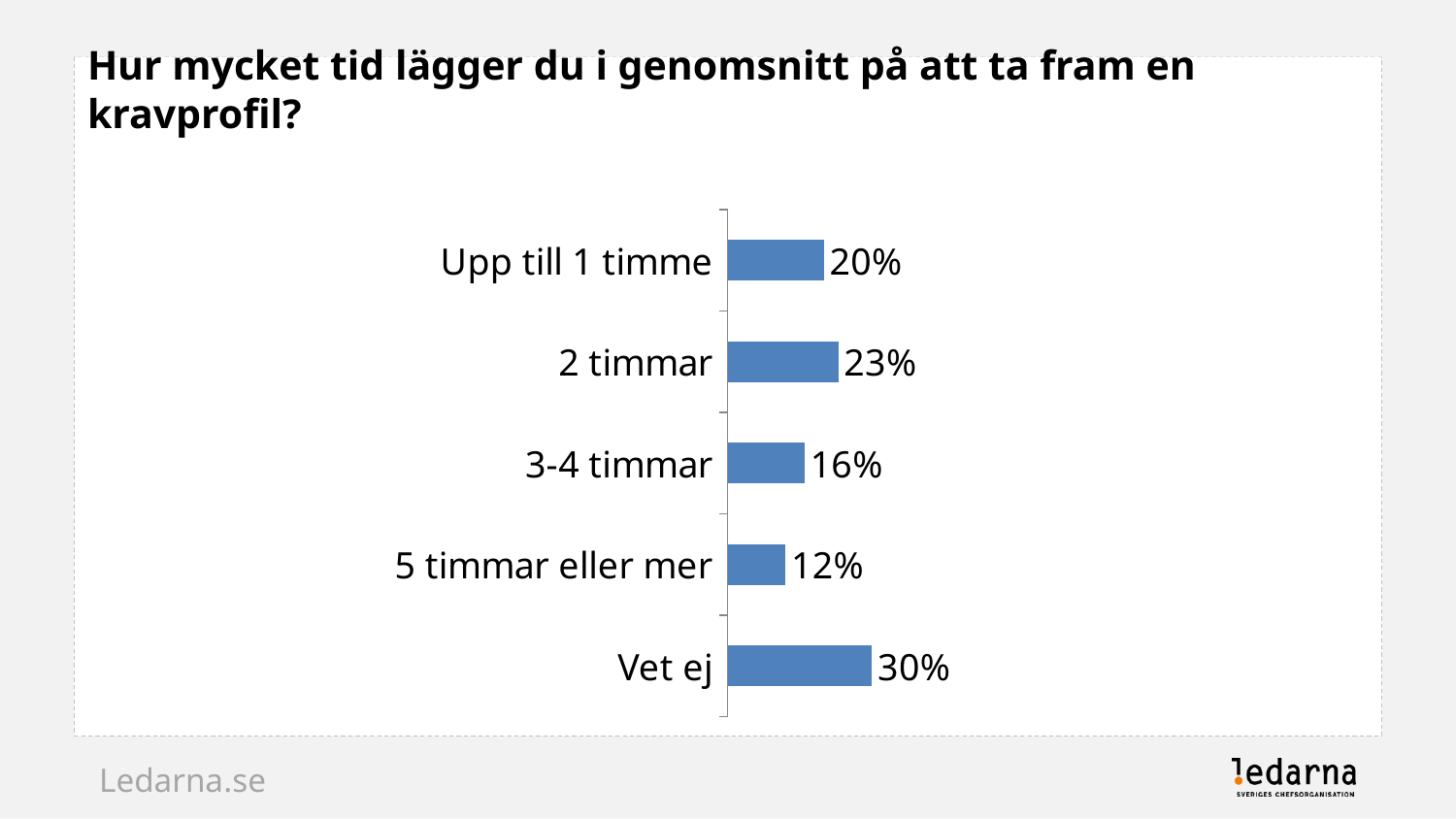
What is the value for "2 timmar"? 23% Which category has the highest value? Vet ej What is the title of the chart on the slide? Hur mycket tid lägger du i genomsnitt på att ta fram en kravprofil? Which is larger, the value for "Upp till 1 timme" or the value for "3-4 timmar"? Upp till 1 timme What is the value for "5 timmar eller mer"? 12% What is the value for "Upp till 1 timme"? 20% How many categories are shown in the chart? 5 What is the difference between the values for "Vet ej" and "3-4 timmar"? 14% What is the difference between the values for "2 timmar" and "Upp till 1 timme"? 3% What kind of chart is shown on the slide? Bar chart What is the value for "Vet ej"? 30% Which category has the lowest value? 5 timmar eller mer